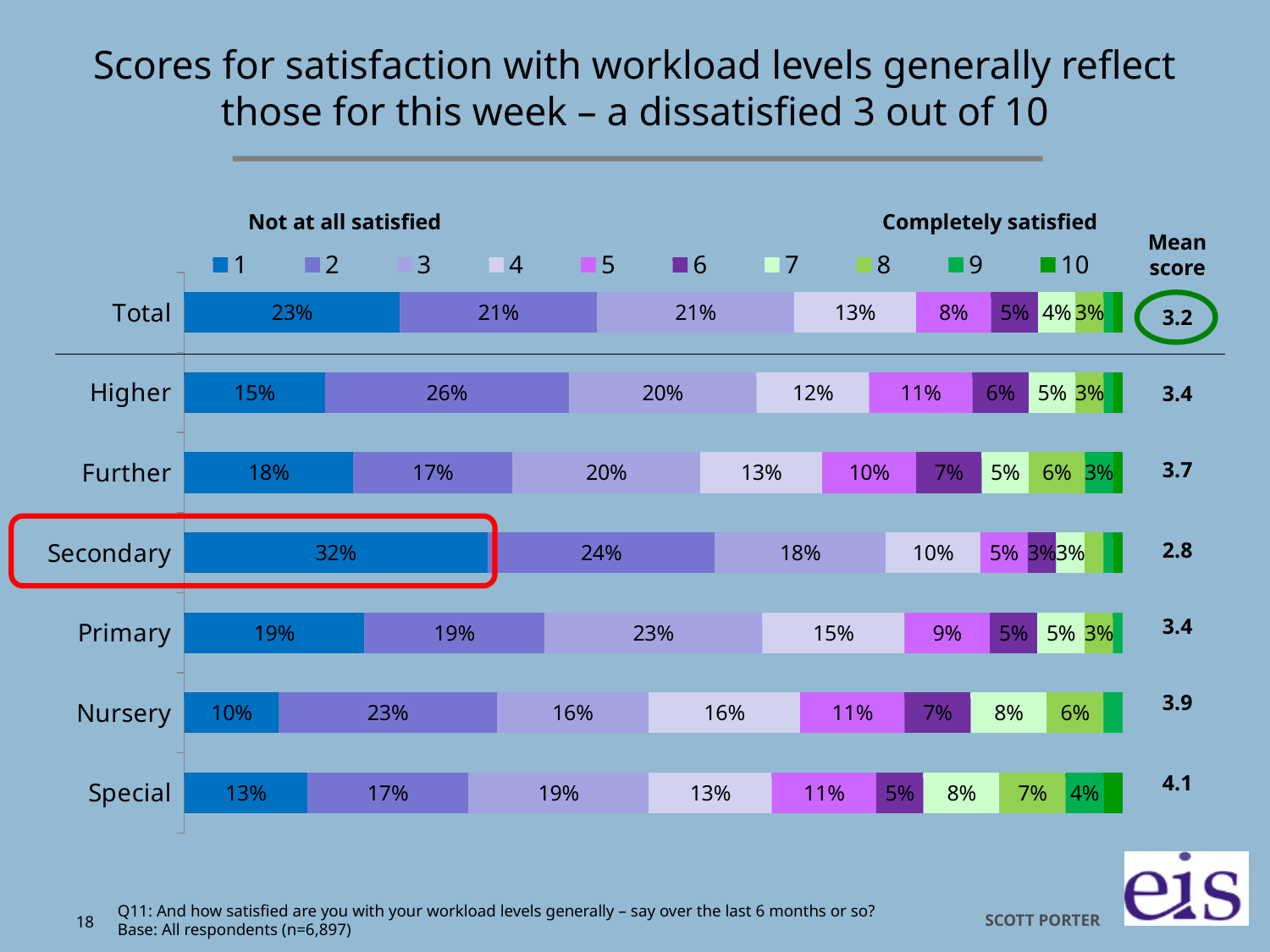
How many series does the legend list? 10 What percentage of Secondary respondents gave a score of 1? 32% What is the difference in percentage points between the score-1 share for Secondary and for Nursery? 22 percentage points Which category has the smallest share of respondents giving a score of 1? Nursery How many categories (bars) are shown in the chart? 7 What percentage of Higher respondents gave a score of 2? 26% What percentage of Special respondents gave a score of 3? 19% What percentage of Nursery respondents gave a score of 1? 10% Which category has the largest share of respondents giving a score of 1? Secondary What is the mean score shown for Total? 3.2 Which category has the highest mean score? Special Which has a larger share of respondents giving a score of 2: Higher or Further? Higher